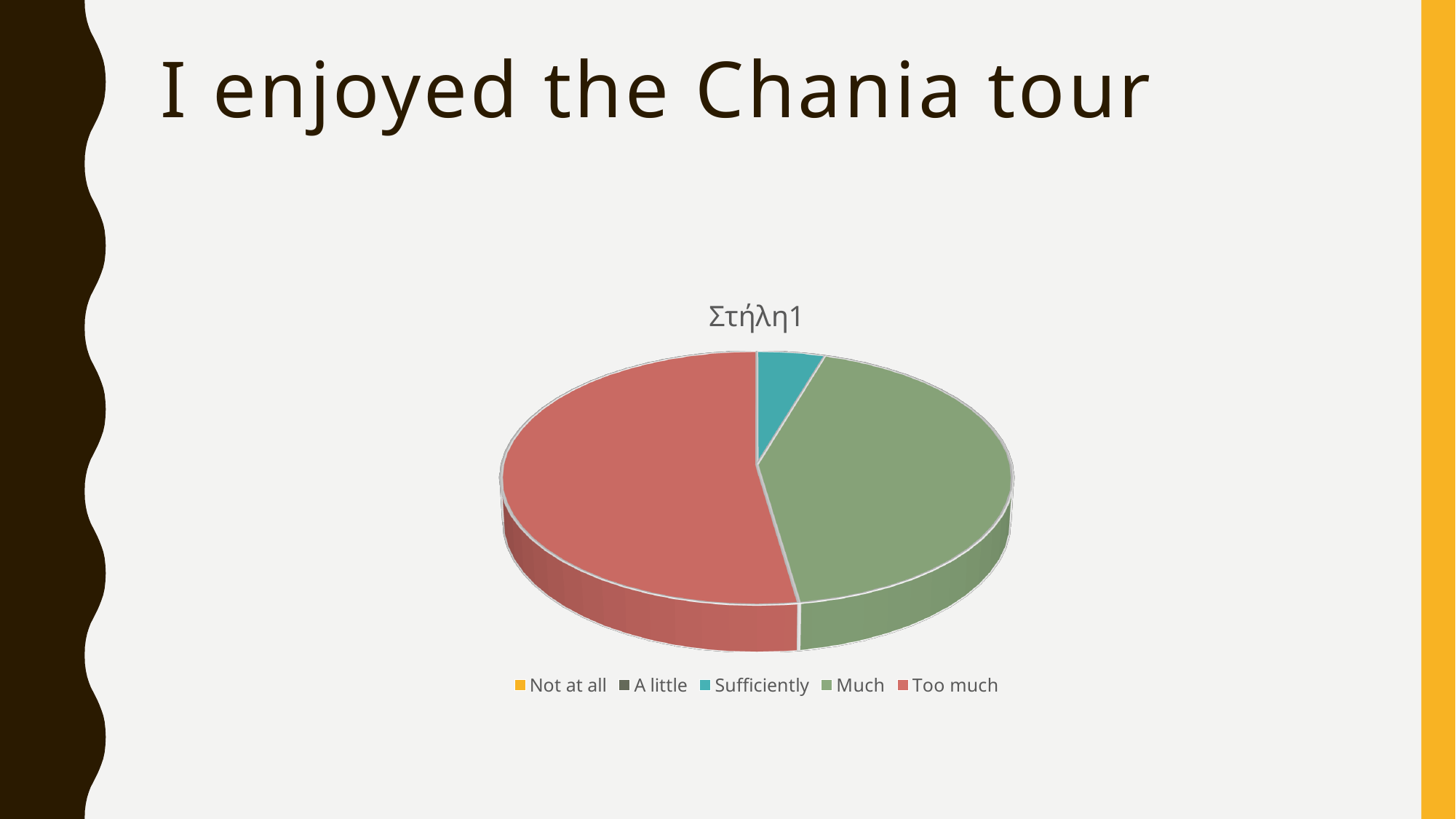
Which slice is larger in the pie chart, "Sufficiently" or "Too much"? Too much Which category has the largest slice of the pie chart? Too much Which of the visible slices in the pie chart is the smallest? Sufficiently What colour is the "Too much" slice in the pie chart? Red Which slice is larger in the pie chart, "Much" or "Sufficiently"? Much What kind of chart is shown on the slide? Pie chart What is the title printed above the pie chart? Στήλη1 How many categories does the legend of the pie chart list? 5 Which slice is larger in the pie chart, "Too much" or "Much"? Too much